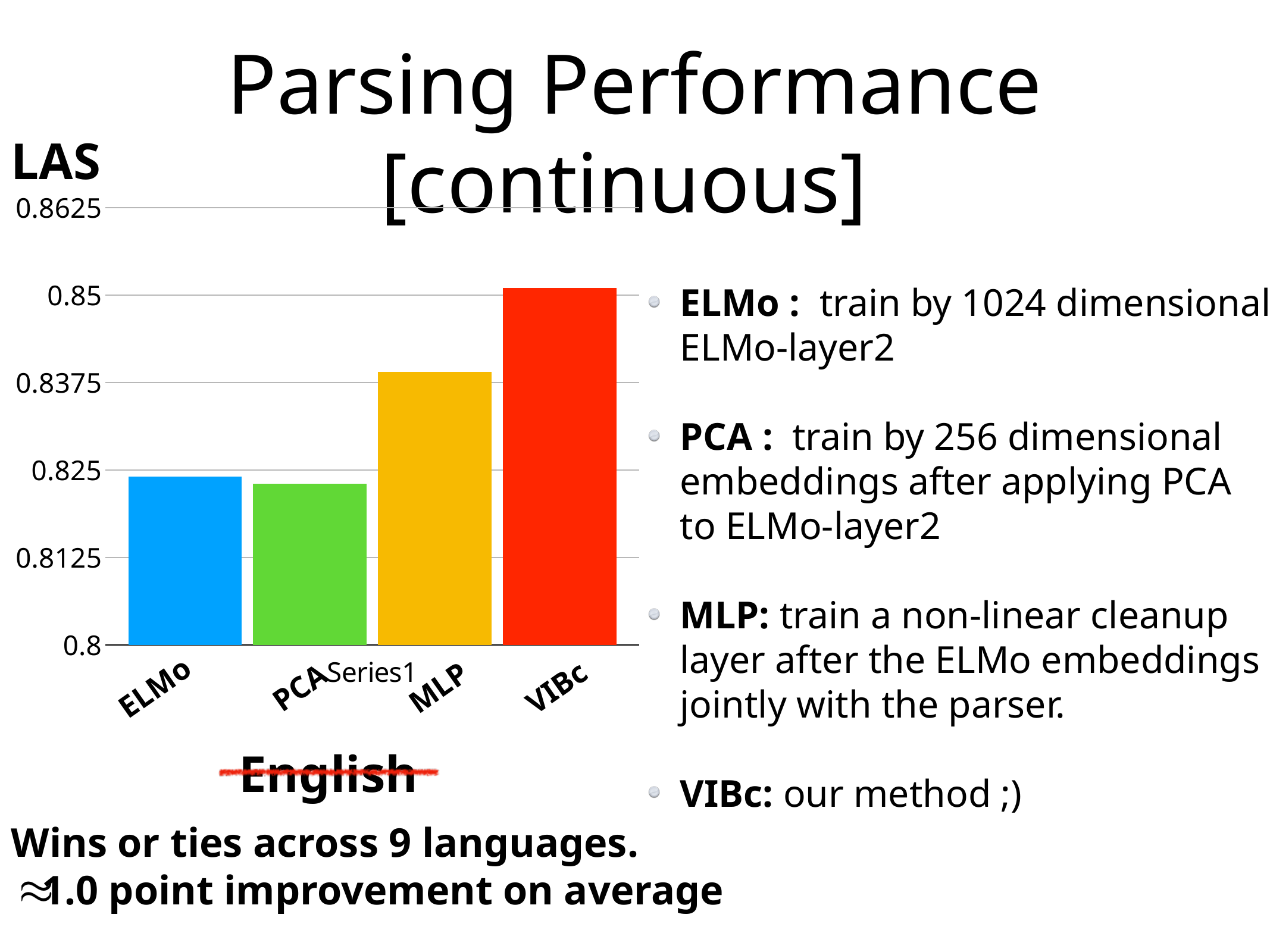
Is the value for ELMo greater or less than 0.8125? greater Which has a higher LAS value, VIBc or MLP? VIBc Is the value for VIBc greater or less than 0.8375? greater Which category has the highest LAS value in the chart? VIBc Is the value for MLP greater or less than 0.8375? greater What label is shown on the y axis of the chart? LAS How many categories are plotted on the x axis of the chart? 4 Which has a higher LAS value, MLP or ELMo? MLP What kind of chart is shown on the slide? bar chart How many series does the chart's legend list? 1